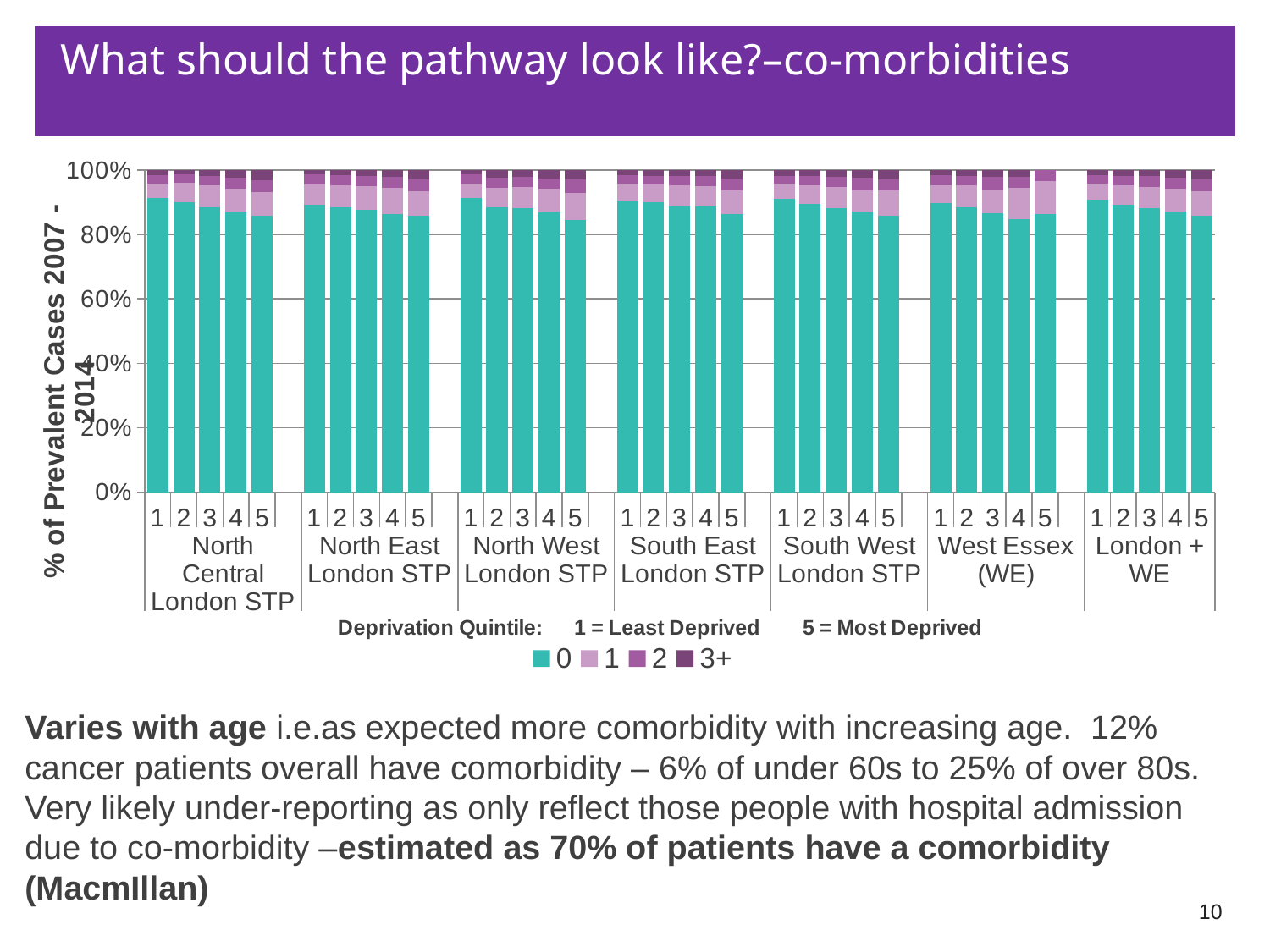
What is the total height of each stacked bar in the chart? 100% Is the value of the '0' segment for deprivation quintile 1 in North Central London STP greater or less than 80%? greater Within North West London STP, does the '0' segment rise or fall as the deprivation quintile goes from 1 to 5? fall How many series does the chart legend list? 4 Is the value of the '0' segment for deprivation quintile 5 in West Essex (WE) greater or less than 80%? greater Within London + WE, is the '0' segment larger for deprivation quintile 1 or quintile 5? Quintile 1 What are the entries in the chart legend? 0, 1, 2, 3+ How many regions (STP groups) are shown along the x axis of the chart? 7 What is the title of the y axis of the chart? % of Prevalent Cases 2007 - 2014 What does deprivation quintile 5 represent according to the x-axis note? Most Deprived How many bars are plotted in the chart in total? 35 What kind of chart is shown on the slide? Stacked bar chart